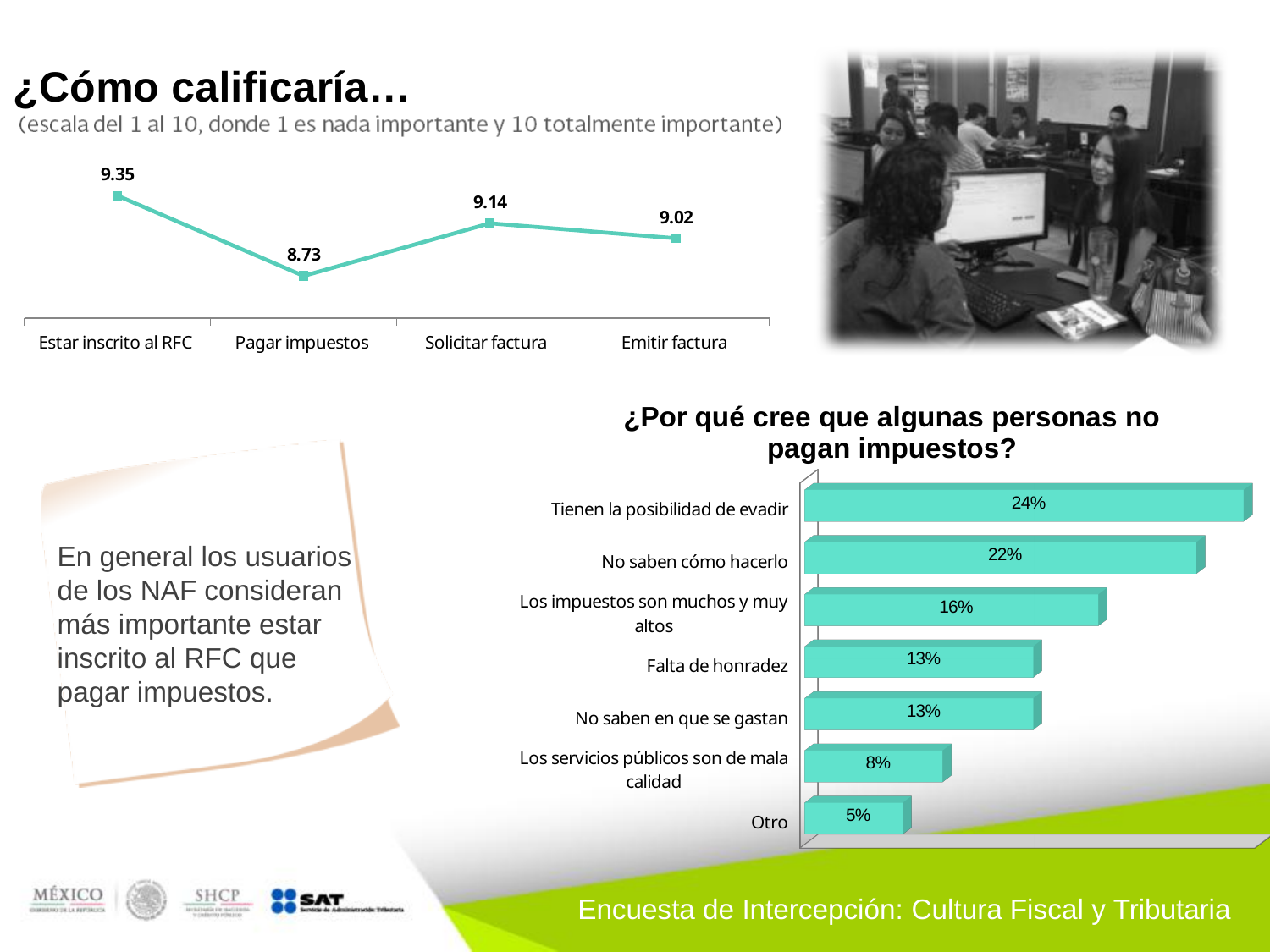
In the '¿Cómo calificaría…' chart, which category has the lowest value? Pagar impuestos In the '¿Por qué cree que algunas personas no pagan impuestos?' chart, which category has the lowest value? Otro In the '¿Cómo calificaría…' chart, how many categories are plotted? 4 What kind of chart is the '¿Cómo calificaría…' chart? Line chart In the '¿Por qué cree que algunas personas no pagan impuestos?' chart, what is the value for No saben cómo hacerlo? 22% In the '¿Cómo calificaría…' chart, what is the difference between Estar inscrito al RFC and Pagar impuestos? 0.62 In the '¿Por qué cree que algunas personas no pagan impuestos?' chart, what is the difference between Tienen la posibilidad de evadir and Los impuestos son muchos y muy altos? 8% What kind of chart is the '¿Por qué cree que algunas personas no pagan impuestos?' chart? Bar chart In the '¿Cómo calificaría…' chart, what is the value for Estar inscrito al RFC? 9.35 In the '¿Por qué cree que algunas personas no pagan impuestos?' chart, how many categories are shown? 7 In the '¿Cómo calificaría…' chart, what is the value for Pagar impuestos? 8.73 In the '¿Por qué cree que algunas personas no pagan impuestos?' chart, which category has the highest value? Tienen la posibilidad de evadir